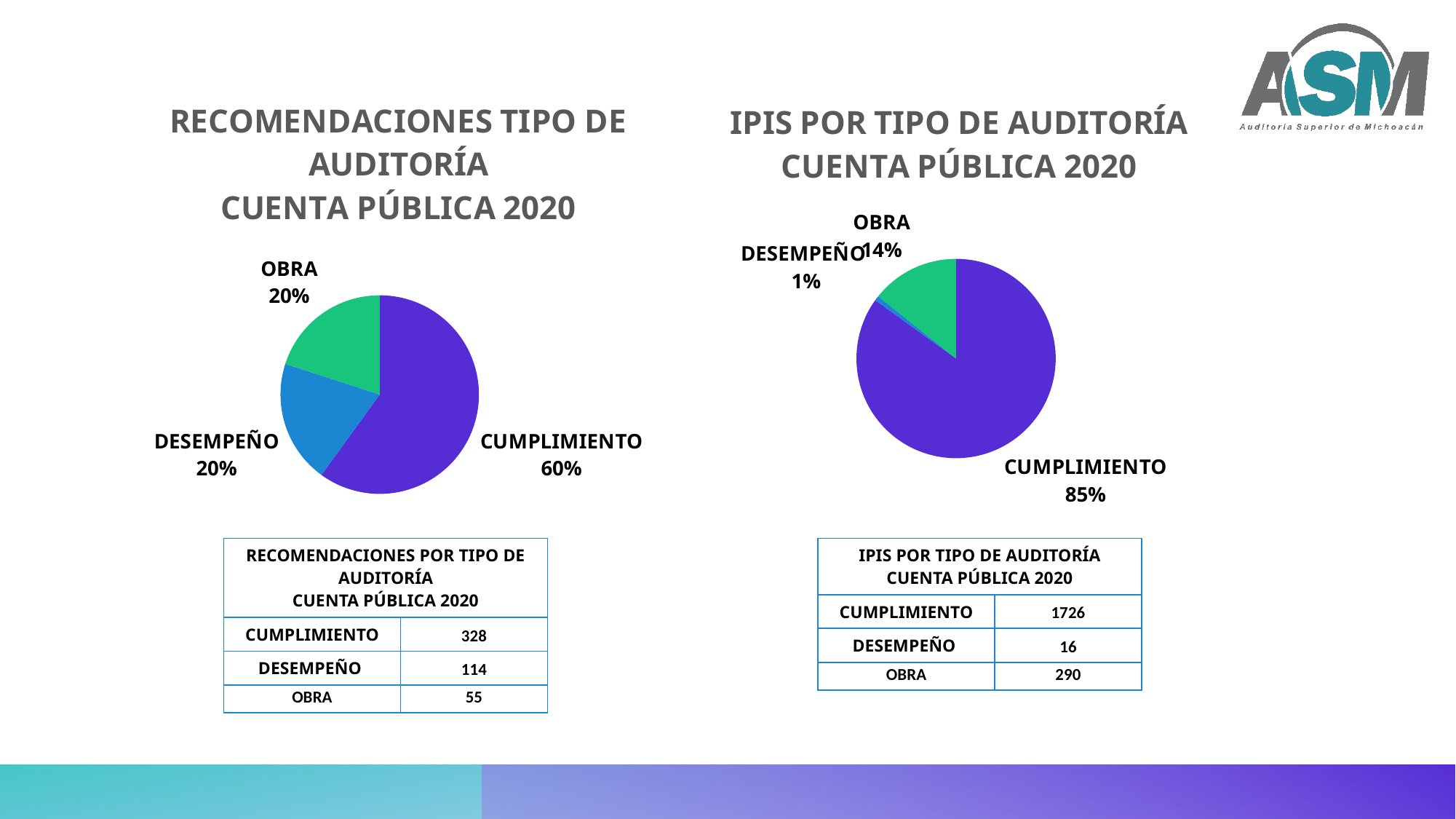
In the 'RECOMENDACIONES TIPO DE AUDITORÍA CUENTA PÚBLICA 2020' chart, what colour is the CUMPLIMIENTO slice? Purple In the 'IPIS POR TIPO DE AUDITORÍA CUENTA PÚBLICA 2020' chart, which slice is larger, OBRA or DESEMPEÑO? OBRA In the 'IPIS POR TIPO DE AUDITORÍA CUENTA PÚBLICA 2020' chart, which category has the smallest slice? DESEMPEÑO In the 'RECOMENDACIONES TIPO DE AUDITORÍA CUENTA PÚBLICA 2020' chart, how many slices does the pie have? 3 What kind of chart is the 'RECOMENDACIONES TIPO DE AUDITORÍA CUENTA PÚBLICA 2020' chart? Pie chart In the 'RECOMENDACIONES TIPO DE AUDITORÍA CUENTA PÚBLICA 2020' chart, what share of the pie is CUMPLIMIENTO? 60% In the 'IPIS POR TIPO DE AUDITORÍA CUENTA PÚBLICA 2020' chart, what is the difference in percentage points between CUMPLIMIENTO and OBRA? 71 percentage points In the 'IPIS POR TIPO DE AUDITORÍA CUENTA PÚBLICA 2020' chart, what share of the pie is OBRA? 14% In the 'IPIS POR TIPO DE AUDITORÍA CUENTA PÚBLICA 2020' chart, what share of the pie is CUMPLIMIENTO? 85% In the 'RECOMENDACIONES TIPO DE AUDITORÍA CUENTA PÚBLICA 2020' chart, which category has the largest slice? CUMPLIMIENTO